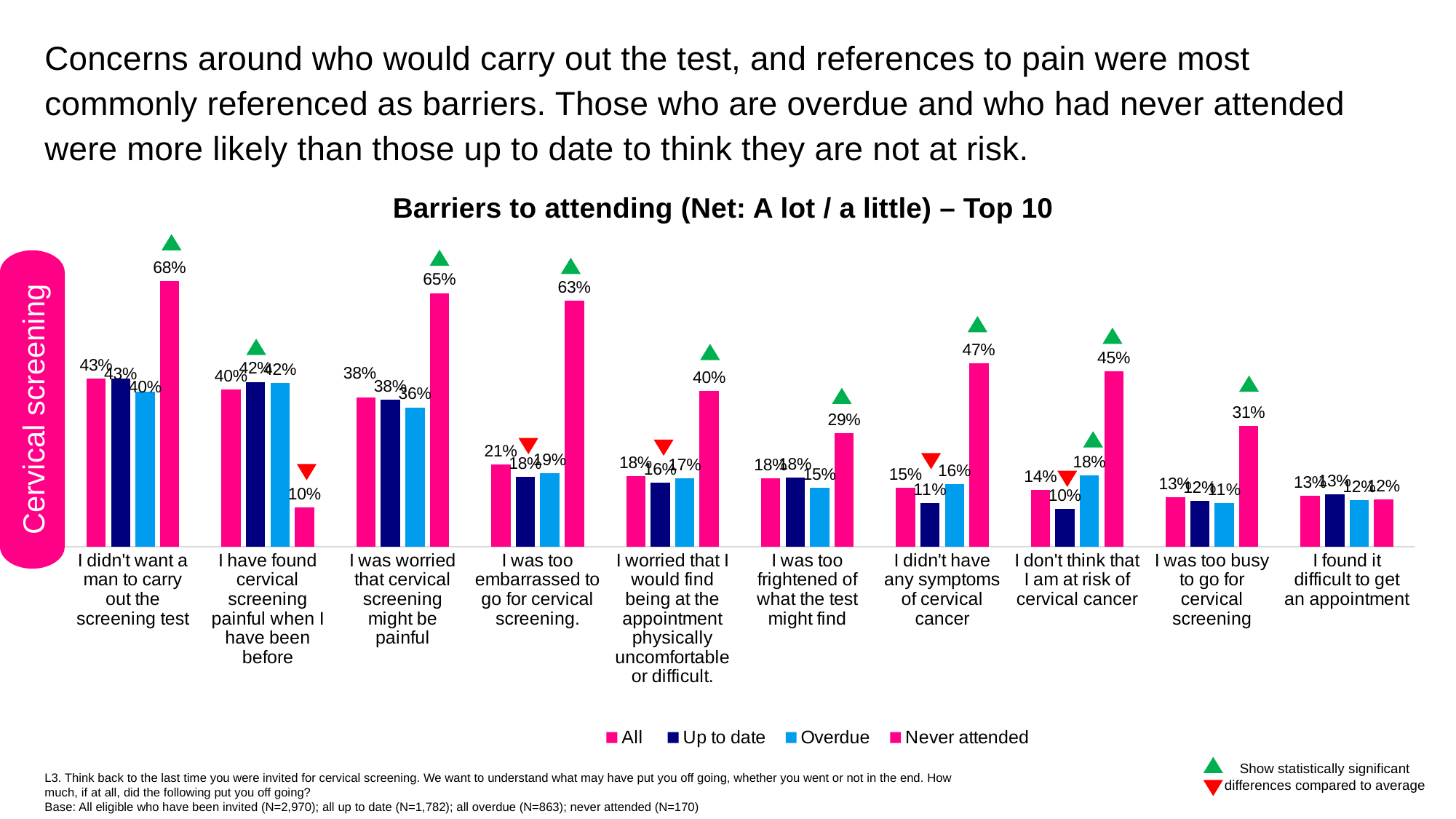
What is the value for 'Never attended' for 'I have found cervical screening painful when I have been before'? 10% How many series does the legend list? 4 Which category has the highest 'Never attended' value? I didn't want a man to carry out the screening test What is the difference between the 'Never attended' value (65%) and the 'All' value (38%) for 'I was worried that cervical screening might be painful'? 27% What is the value for 'All' for 'I was too embarrassed to go for cervical screening.'? 21% For 'I don't think that I am at risk of cervical cancer', which is larger: the 'Overdue' value or the 'Up to date' value? Overdue How many barrier categories are shown on the x axis? 10 What kind of chart is shown on the slide? Bar chart What is the title of the chart? Barriers to attending (Net: A lot / a little) – Top 10 What is the value for 'Never attended' for 'I didn't want a man to carry out the screening test'? 68% Which category has the lowest 'Never attended' value? I have found cervical screening painful when I have been before What is the value for 'Never attended' for 'I didn't have any symptoms of cervical cancer'? 47%